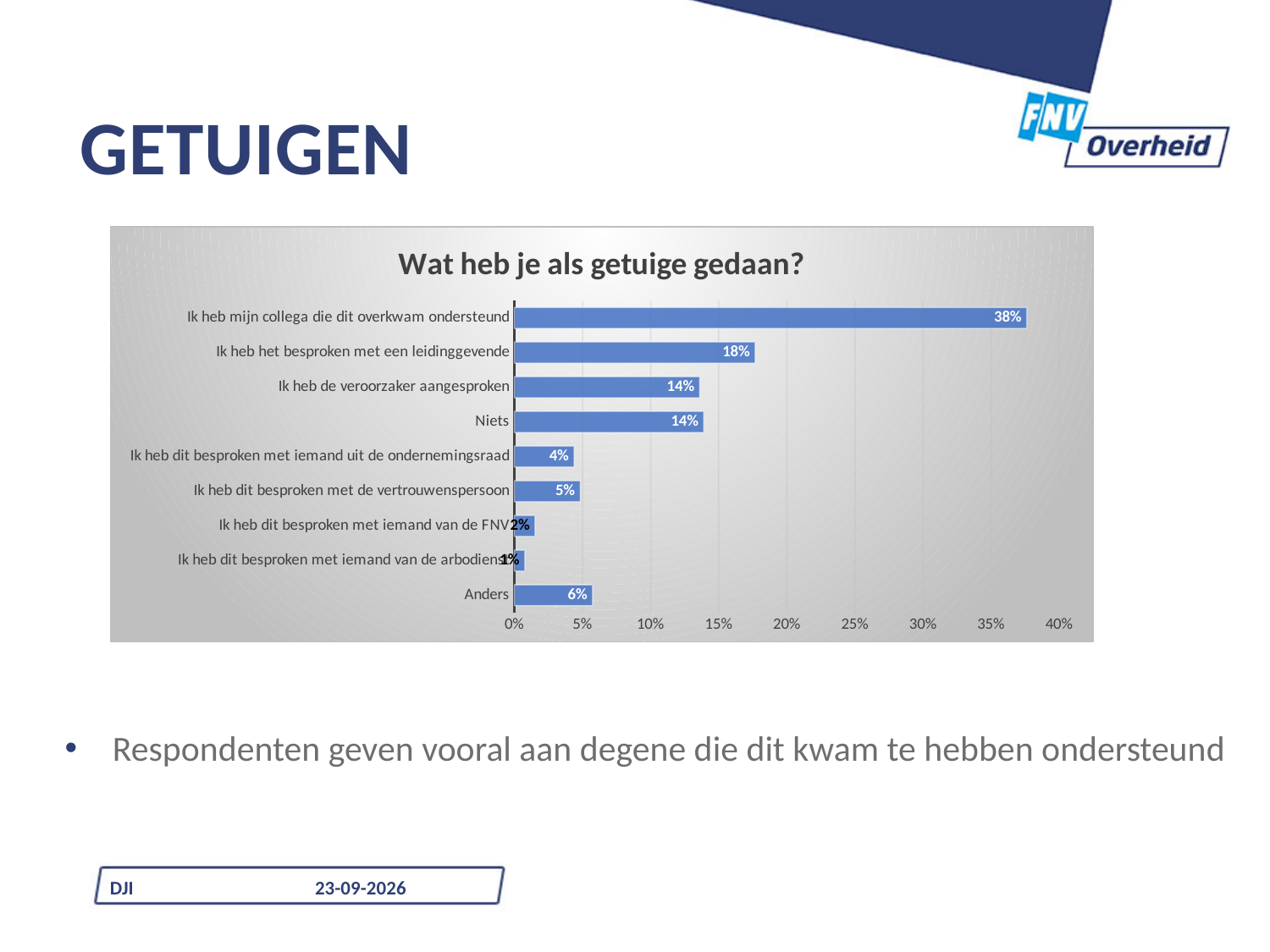
What is the value for 'Ik heb dit besproken met de vertrouwenspersoon'? 5% Is the value for 'Ik heb het besproken met een leidinggevende' greater or less than 15%? greater What is the value for 'Ik heb mijn collega die dit overkwam ondersteund'? 38% Which category has the lowest value? Ik heb dit besproken met iemand van de arbodienst What is the title of the chart? Wat heb je als getuige gedaan? What is the value for 'Anders'? 6% What kind of chart is shown on the slide? Bar chart Which category has the highest value? Ik heb mijn collega die dit overkwam ondersteund What is the difference between 'Ik heb mijn collega die dit overkwam ondersteund' and 'Ik heb het besproken met een leidinggevende'? 20% How many categories are shown in the chart? 9 What is the value for 'Ik heb het besproken met een leidinggevende'? 18% Which is larger: 'Anders' or 'Ik heb dit besproken met iemand uit de ondernemingsraad'? Anders